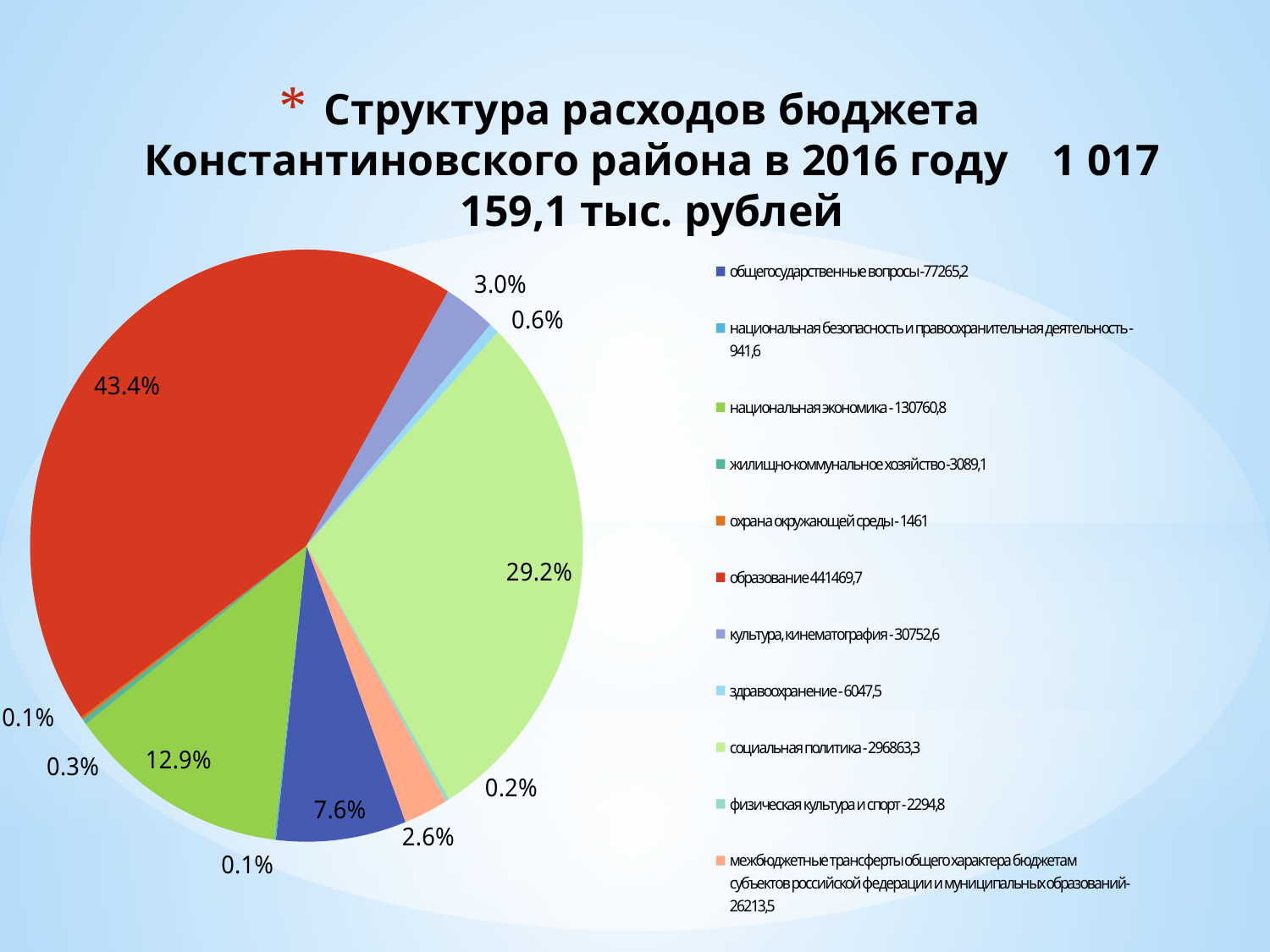
Which slice is larger: образование or социальная политика? образование What total budget expenditure is stated in the chart title? 1 017 159,1 тыс. рублей What type of chart is shown on the slide? pie chart What is the difference in percentage points between the образование slice and the социальная политика slice? 14.2% What share of the pie does образование (education) take? 43.4% Which category has the largest slice of the pie? образование What share of the pie does культура, кинематография take? 3.0% How many categories does the legend list? 11 What share of the pie does социальная политика take? 29.2% What amount is given in the legend for образование? 441469,7